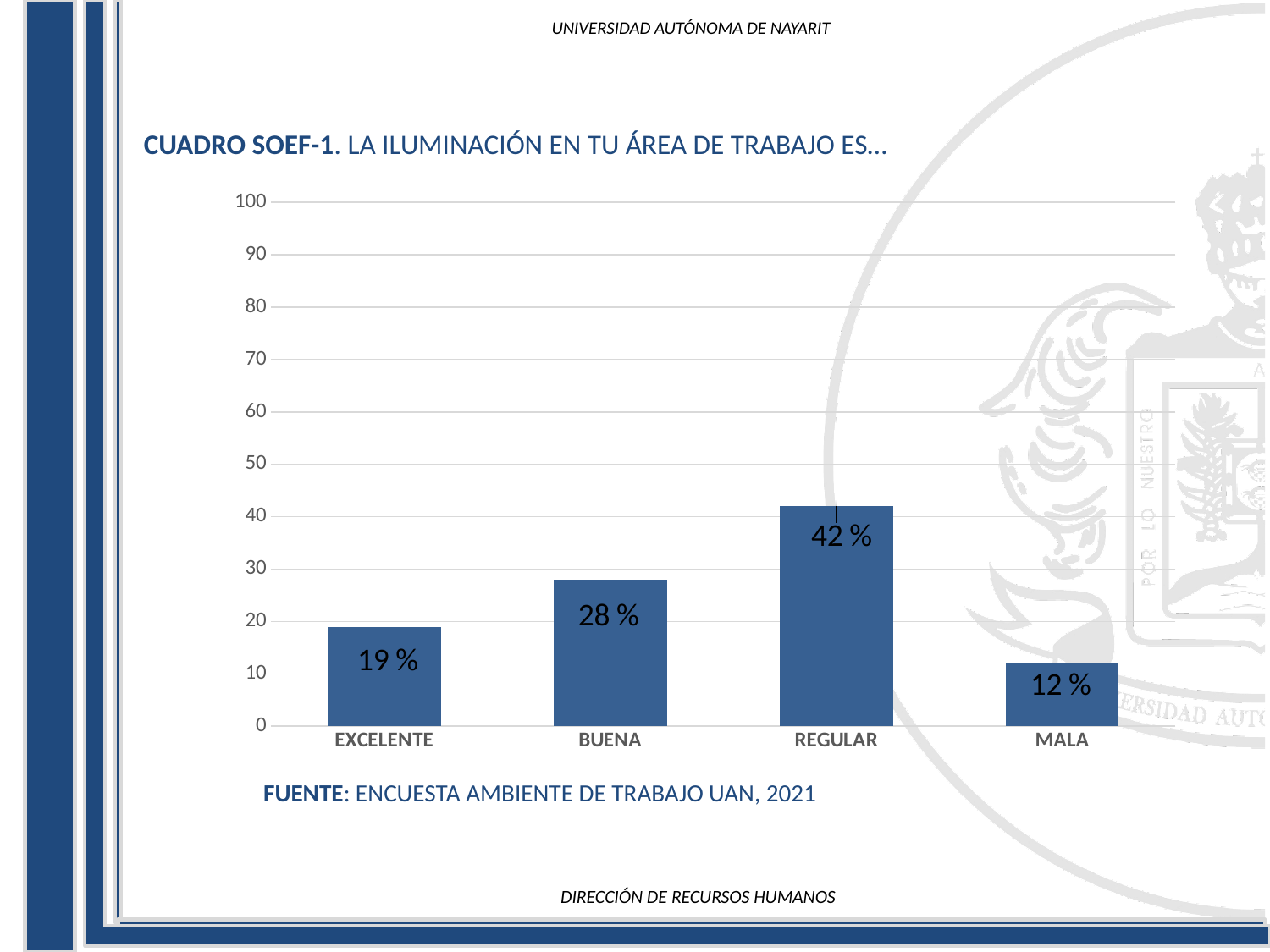
What is the title of the chart? CUADRO SOEF-1. LA ILUMINACIÓN EN TU ÁREA DE TRABAJO ES… What is the value for EXCELENTE? 19 % What is the value for REGULAR? 42 % Which category has the highest value? REGULAR What source is cited below the chart? ENCUESTA AMBIENTE DE TRABAJO UAN, 2021 Which is larger, the value for EXCELENTE or the value for BUENA? BUENA Which category has the lowest value? MALA What is the difference between the values for REGULAR and BUENA? 14 % What is the value for MALA? 12 % What kind of chart is shown on the slide? bar chart How many categories are shown on the x axis? 4 Is the value for BUENA greater or less than 30? less